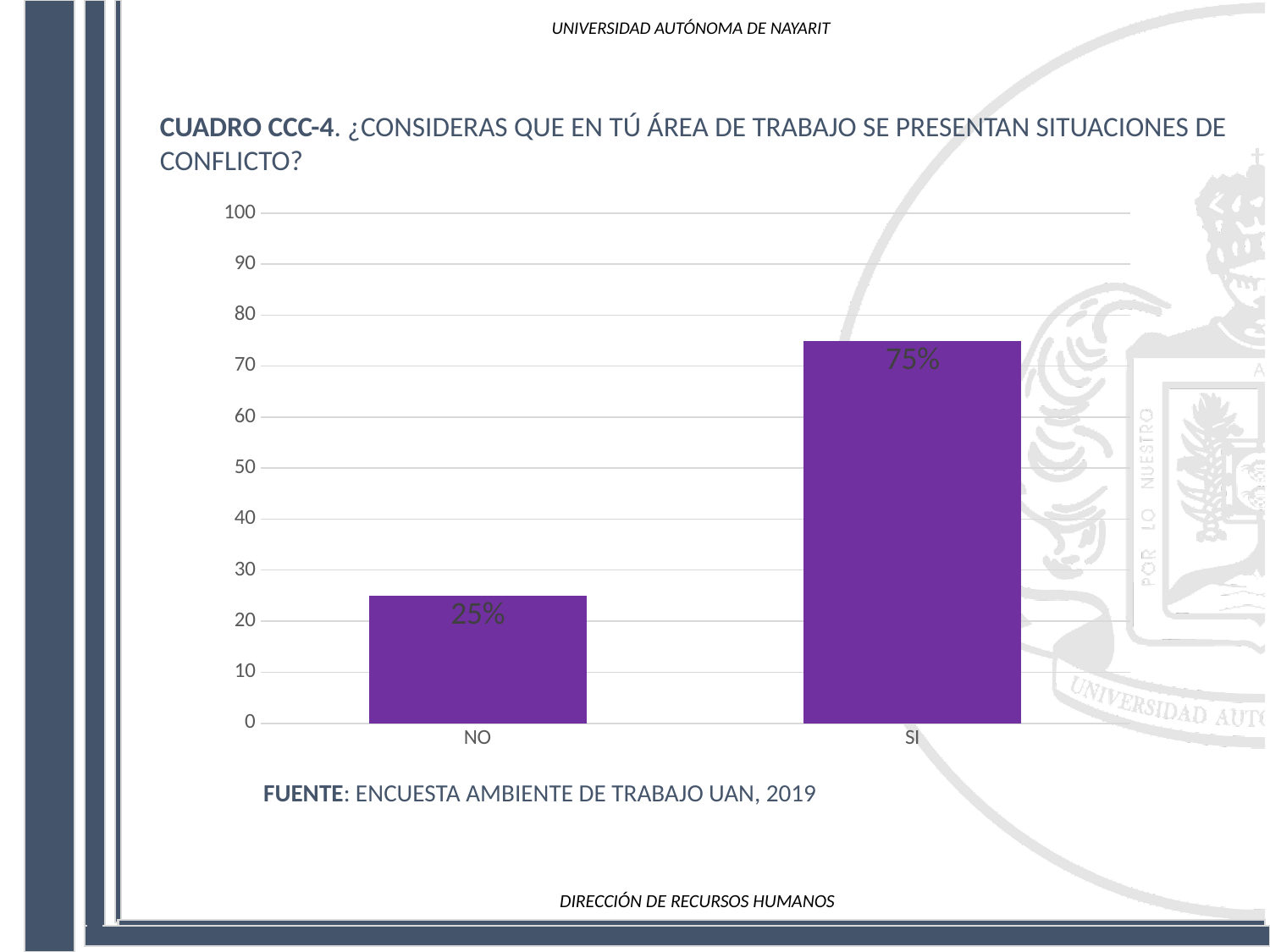
Is the value for SI greater or less than 70? greater Which category has the highest value? SI What is the value for SI? 75% What is the value for NO? 25% What is the maximum value shown on the vertical axis? 100 What kind of chart is shown on the slide? bar chart Is the value for NO greater or less than 30? less Which is larger, the value for NO or the value for SI? SI What source is cited below the chart? ENCUESTA AMBIENTE DE TRABAJO UAN, 2019 What is the difference between the values for SI and NO? 50% Which category has the lowest value? NO How many categories are shown on the x axis? 2